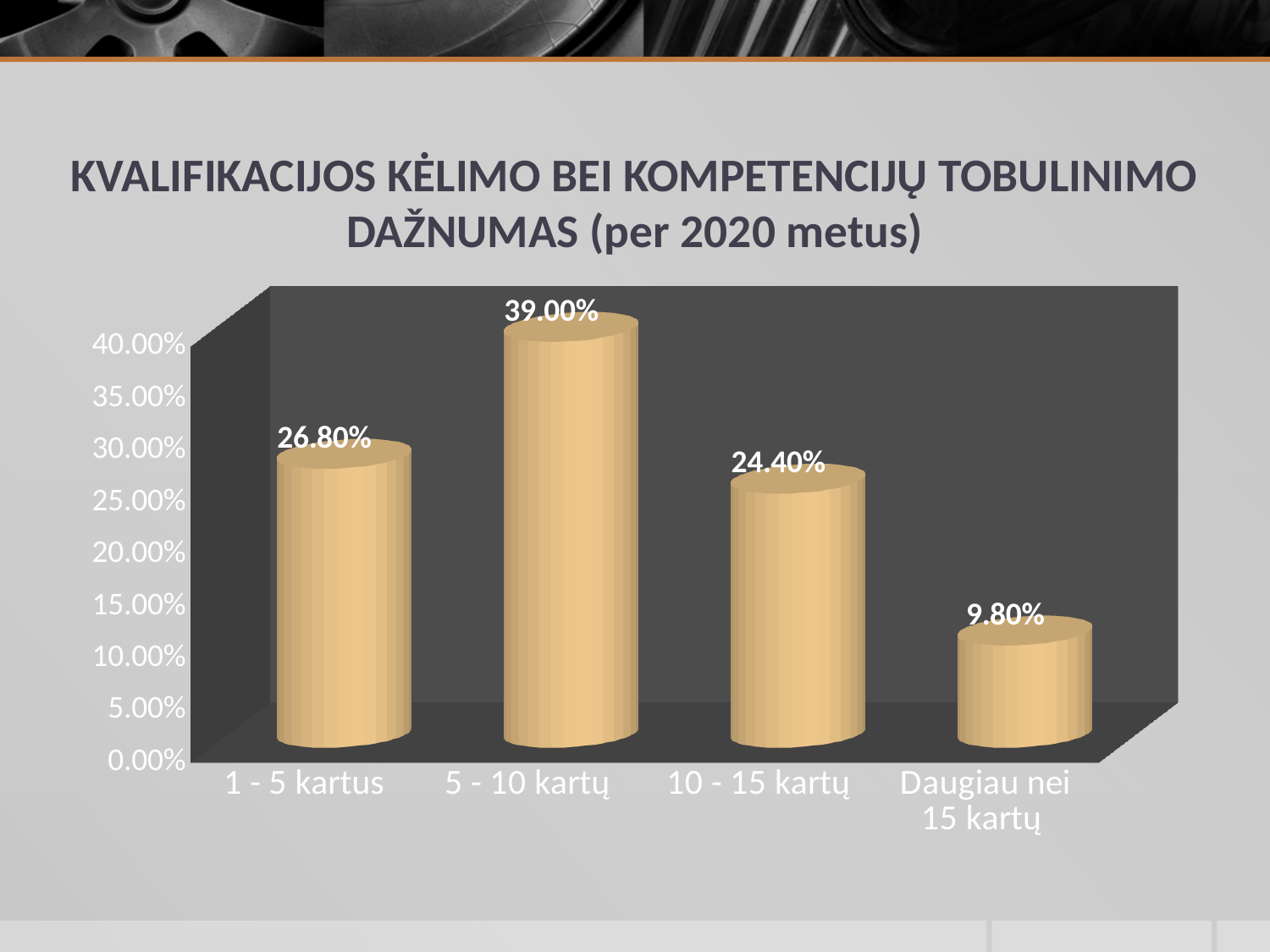
Which category has the highest value? 5 - 10 kartų Which category has the lowest value? Daugiau nei 15 kartų What is the value for "Daugiau nei 15 kartų"? 9.80% Which is larger, the value for "1 - 5 kartus" or the value for "10 - 15 kartų"? 1 - 5 kartus What is the difference between the values for "5 - 10 kartų" and "1 - 5 kartus"? 12.20% How many categories are shown on the x axis? 4 What is the value for "5 - 10 kartų"? 39.00% What is the difference between the values for "10 - 15 kartų" and "Daugiau nei 15 kartų"? 14.60% What is the value for "10 - 15 kartų"? 24.40% What is the title of the chart? KVALIFIKACIJOS KĖLIMO BEI KOMPETENCIJŲ TOBULINIMO DAŽNUMAS (per 2020 metus) What kind of chart is shown on the slide? bar chart What is the value for "1 - 5 kartus"? 26.80%